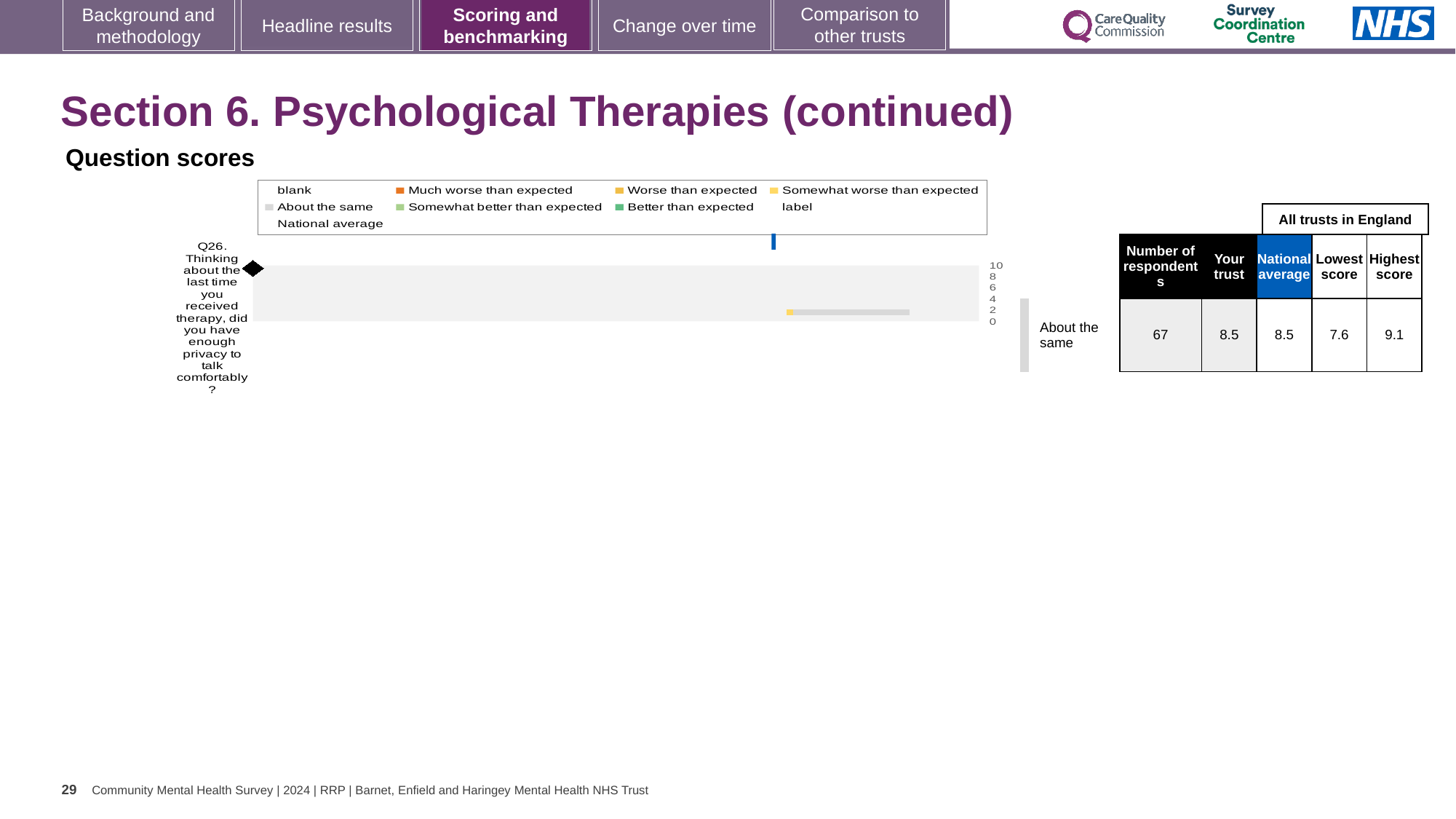
What is the lowest score among all trusts in England for Q26? 7.6 Which is larger for Q26: the 'Your trust' score or the lowest score in England? Your trust Which legend entry is shown in grey in the Question scores chart? About the same What is the national average score for Q26? 8.5 What kind of chart is used to show the Q26 question score? bar chart What is the highest score among all trusts in England for Q26? 9.1 What is the 'Your trust' score for Q26? 8.5 Which question number is plotted in the Question scores chart? Q26 What is the difference between the highest score and the lowest score for Q26? 1.5 How many questions (categories) are plotted in the Question scores chart? 1 How many respondents answered Q26? 67